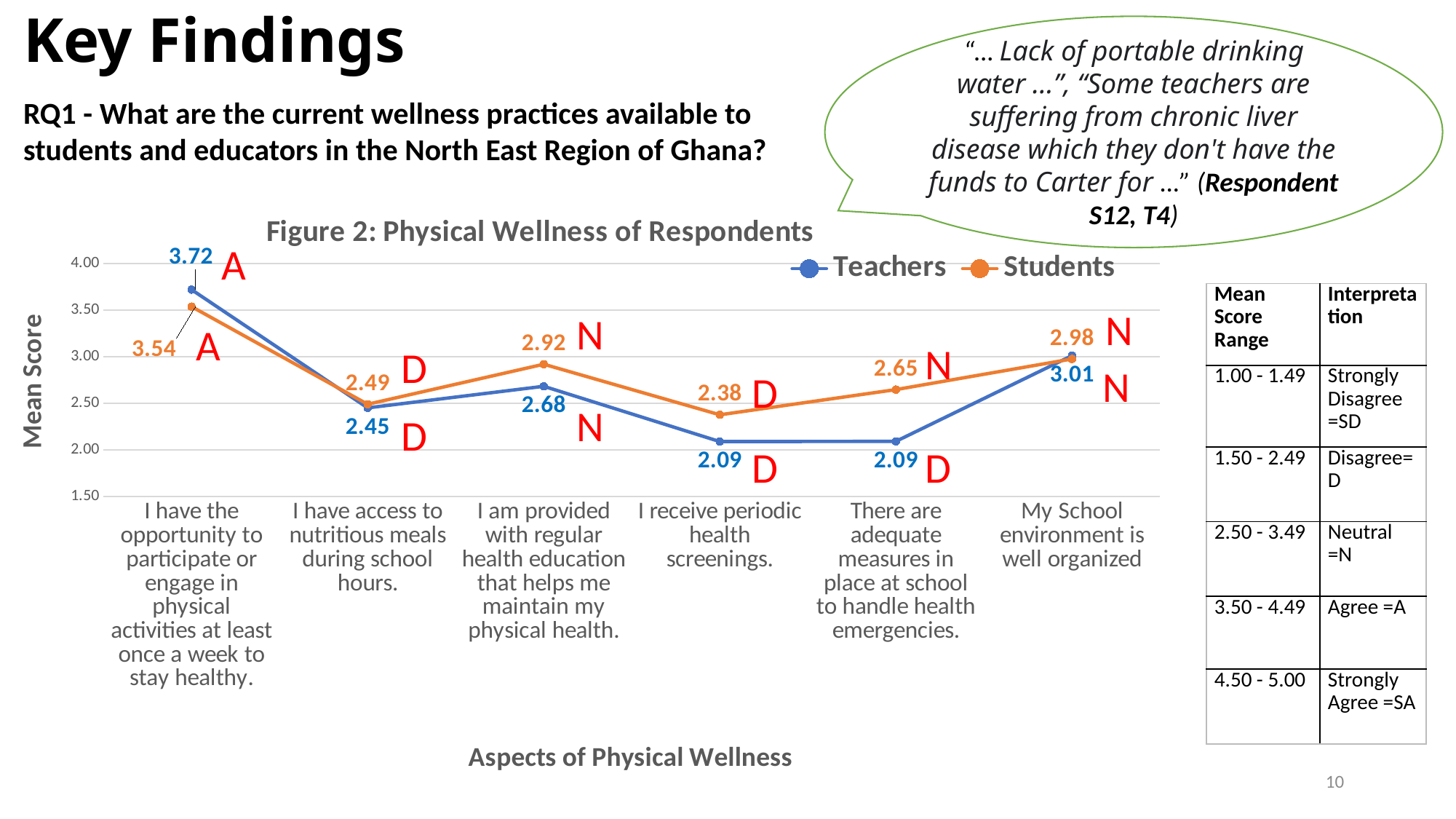
What is the Teachers mean score for 'I have the opportunity to participate or engage in physical activities at least once a week to stay healthy'? 3.72 What is the label of the y axis in Figure 2? Mean Score Is the Teachers mean score for 'I receive periodic health screenings' greater or less than 2.50? less What type of chart is Figure 2: Physical Wellness of Respondents? Line chart What is the difference between the Students and Teachers mean scores for 'There are adequate measures in place at school to handle health emergencies'? 0.56 Which aspect has the lowest Students mean score in Figure 2? I receive periodic health screenings. Which aspect has the highest Teachers mean score in Figure 2? I have the opportunity to participate or engage in physical activities at least once a week to stay healthy. For 'I am provided with regular health education that helps me maintain my physical health', which series has the higher mean score, Teachers or Students? Students How many series does the legend list in Figure 2? 2 What is the Students mean score for 'There are adequate measures in place at school to handle health emergencies'? 2.65 How many aspects of physical wellness are plotted along the x axis in Figure 2? 6 What is the Students mean score for 'I receive periodic health screenings'? 2.38